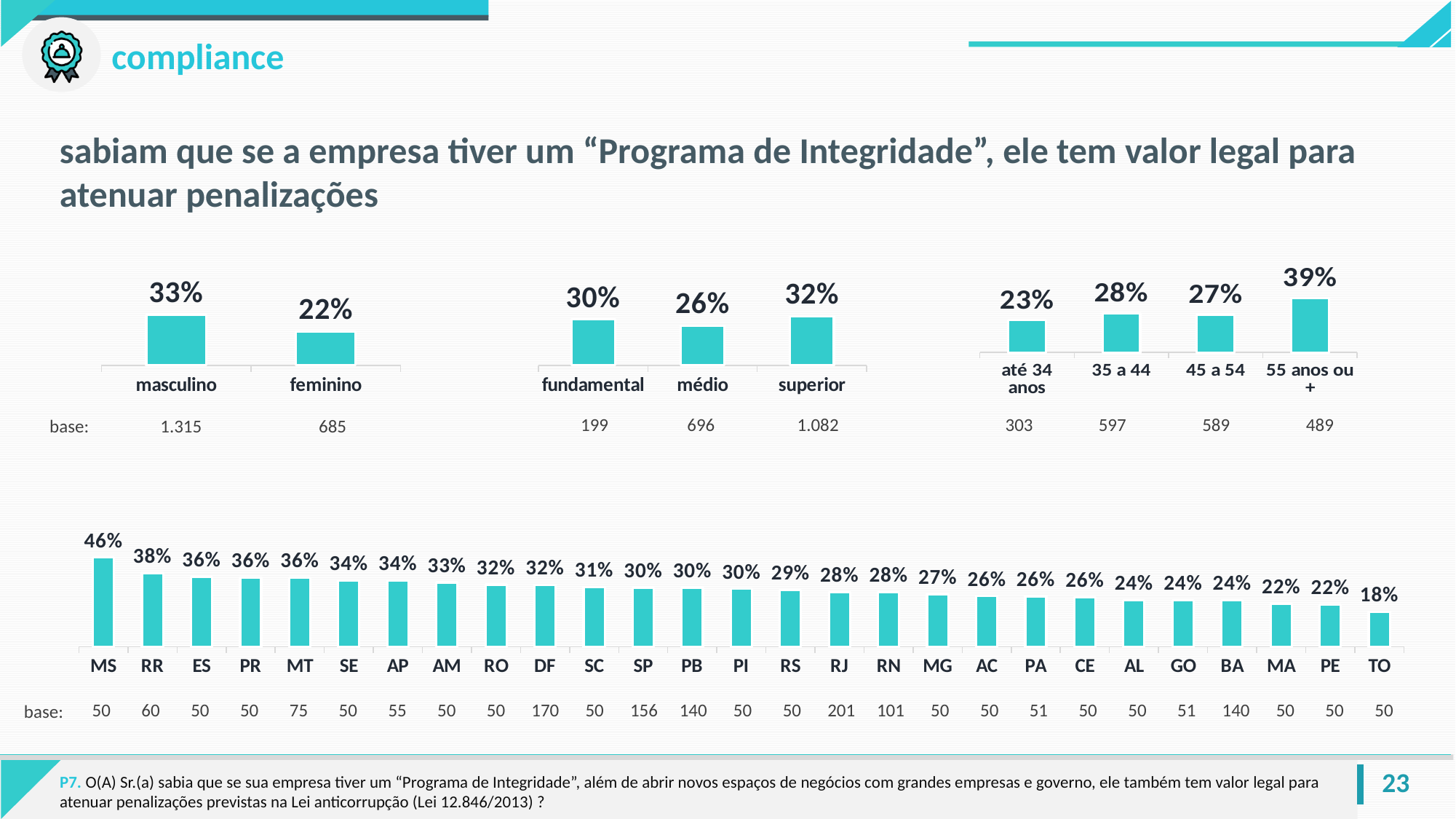
What kind of chart is the state chart at the bottom of the slide? bar chart In the age chart (top right), how many age groups are shown? 4 In the age chart (top right), what is the value for até 34 anos? 23% In the state chart (bottom), what is the value for DF? 32% In the gender chart (top left), what is the value for masculino? 33% In the age chart (top right), which age group has the highest value? 55 anos ou + In the education chart (top centre), which category has the highest value? superior In the gender chart (top left), what is the value for feminino? 22% In the state chart (bottom), how many states are shown? 27 In the gender chart (top left), what is the difference between masculino and feminino? 11% In the state chart (bottom), which state has the lowest value? TO In the education chart (top centre), what is the value for médio? 26%